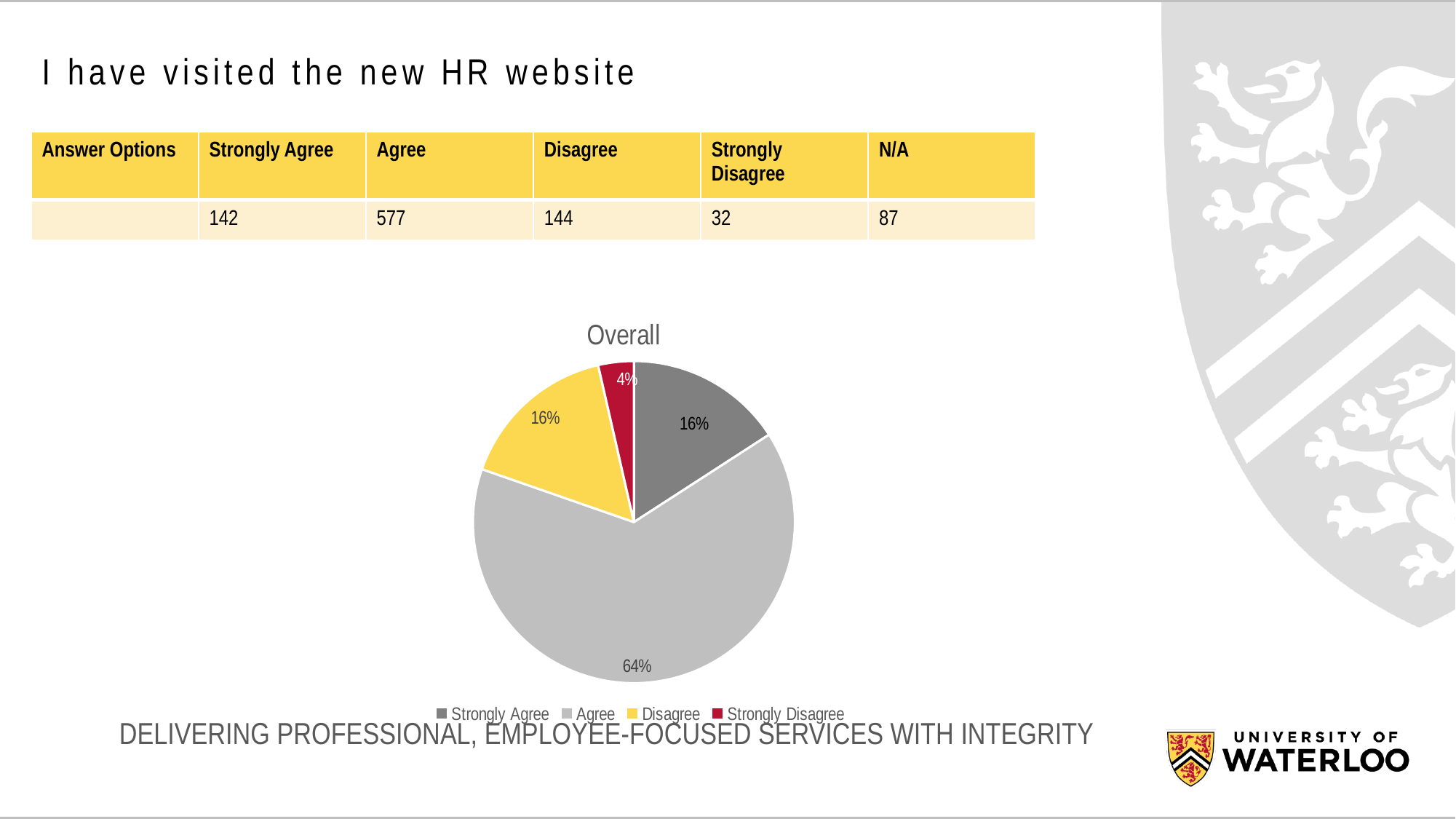
What percentage of the pie does the Agree slice represent? 64% What percentage of the pie does the Strongly Agree slice represent? 16% Which slice is larger, Agree or Strongly Disagree? Agree What percentage of the pie does the Strongly Disagree slice represent? 4% What is the difference in percentage points between the Agree slice and the Disagree slice? 48 How many entries does the legend list? 4 What is the title of the chart? Overall What colour is the Strongly Disagree slice? red Which category has the smallest slice of the pie? Strongly Disagree Which category has the largest slice of the pie? Agree What type of chart is shown on the slide? pie chart How many slices does the pie chart have? 4